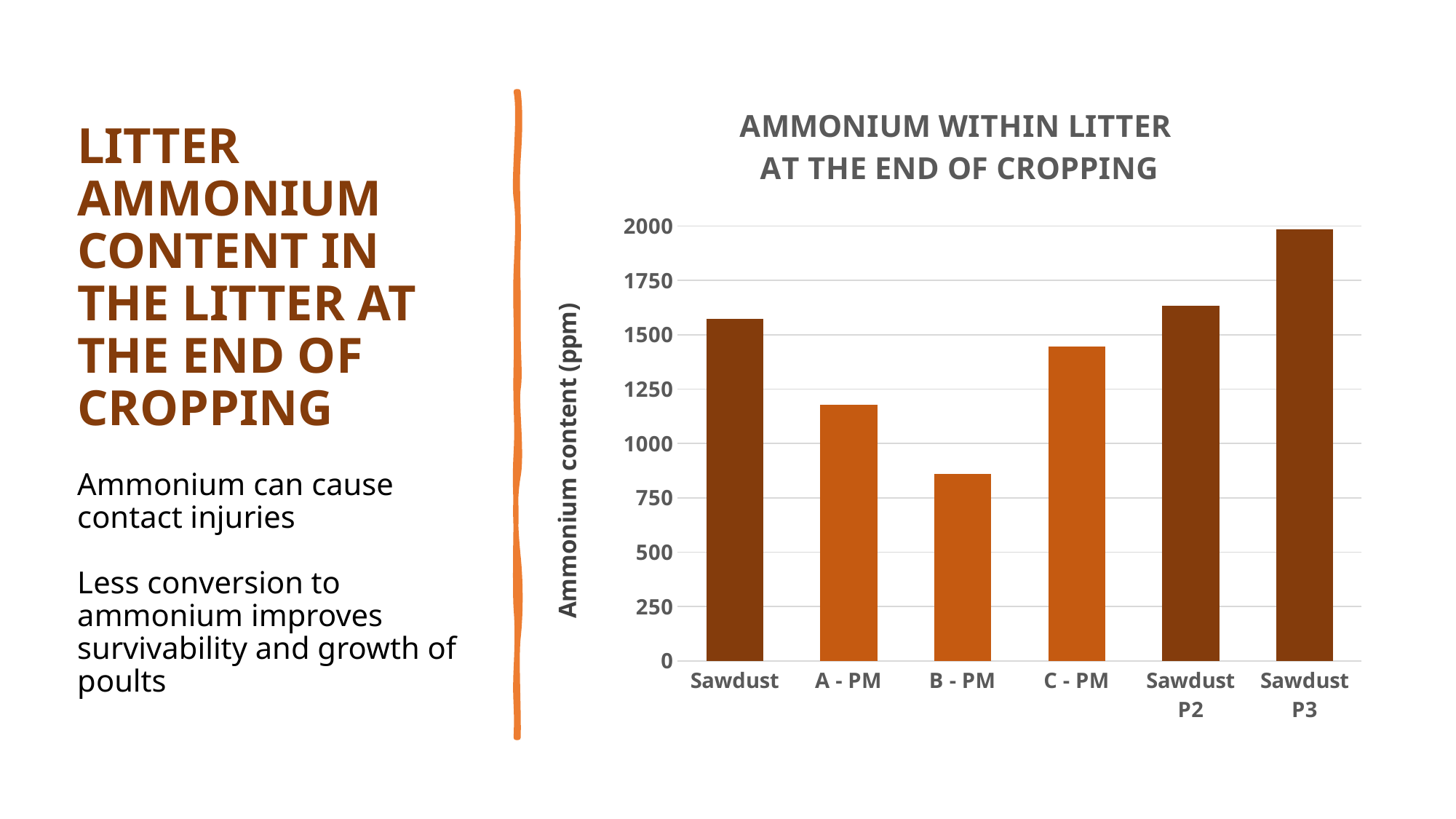
How many categories are shown on the x axis of the chart? 6 Is the value for A - PM greater or less than 1250? less Which category has the highest ammonium content? Sawdust P3 Is the value for Sawdust greater or less than 1500? greater Which has a higher ammonium content, C - PM or Sawdust P2? Sawdust P2 What is the label of the vertical axis of the chart? Ammonium content (ppm) Is the value for Sawdust P2 greater or less than 1500? greater Which has a higher ammonium content, Sawdust or A - PM? Sawdust What kind of chart is shown on the slide? bar chart Which category has the lowest ammonium content? B - PM